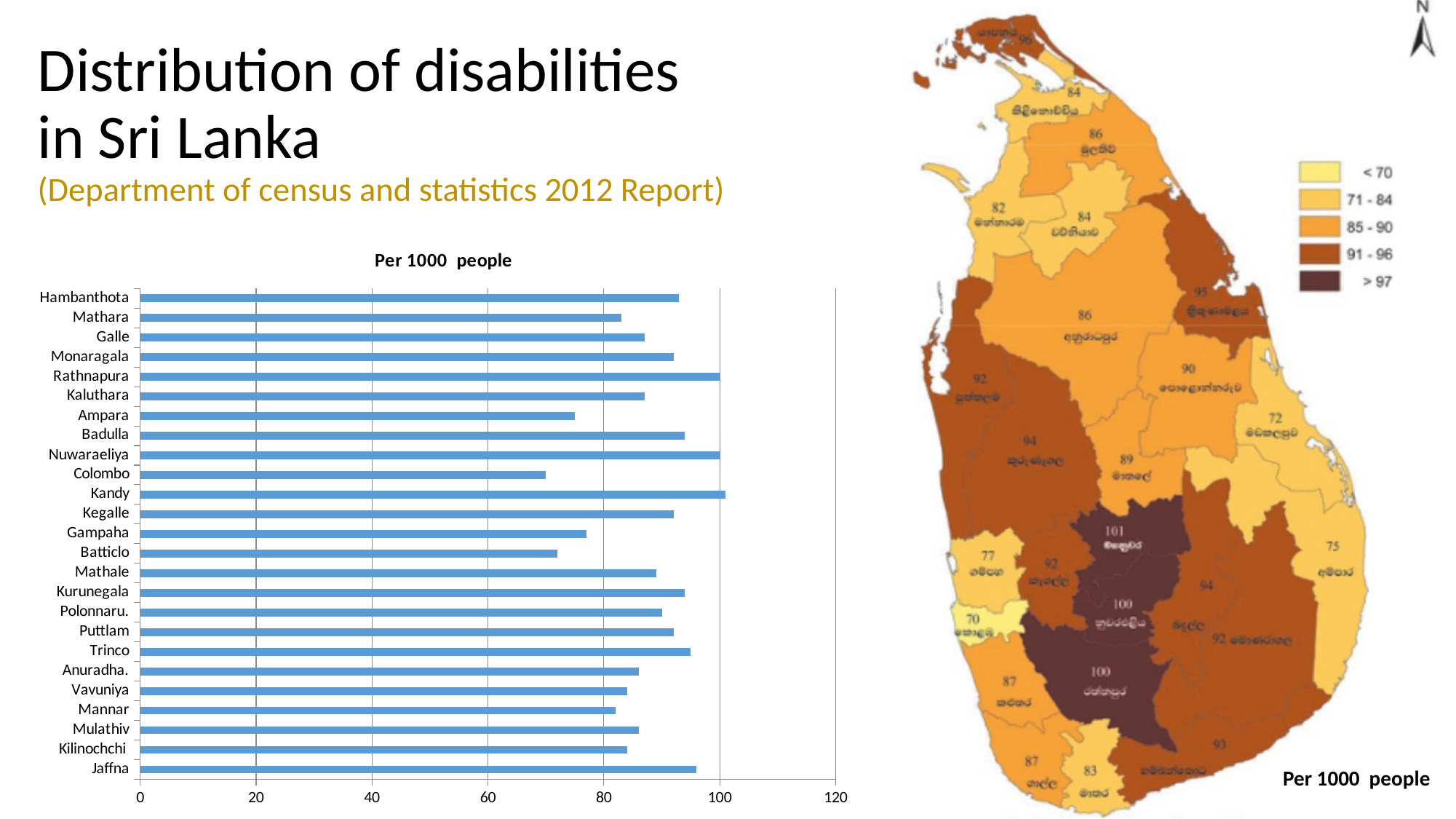
On the bar chart, which has the larger value, Badulla or Ampara? Badulla How many districts are listed on the bar chart? 25 What kind of chart is used to show the disability rates by district? bar chart What is the highest value shown on the bar chart's horizontal axis? 120 On the bar chart, is the value for Gampaha greater or less than 80? less On the bar chart, is the value for Colombo greater or less than 80? less What is the title of the bar chart? Per 1000 people On the bar chart, is the value for Jaffna greater or less than 80? greater On the bar chart, which has the larger value, Kandy or Colombo? Kandy On the bar chart, which has the larger value, Jaffna or Mannar? Jaffna